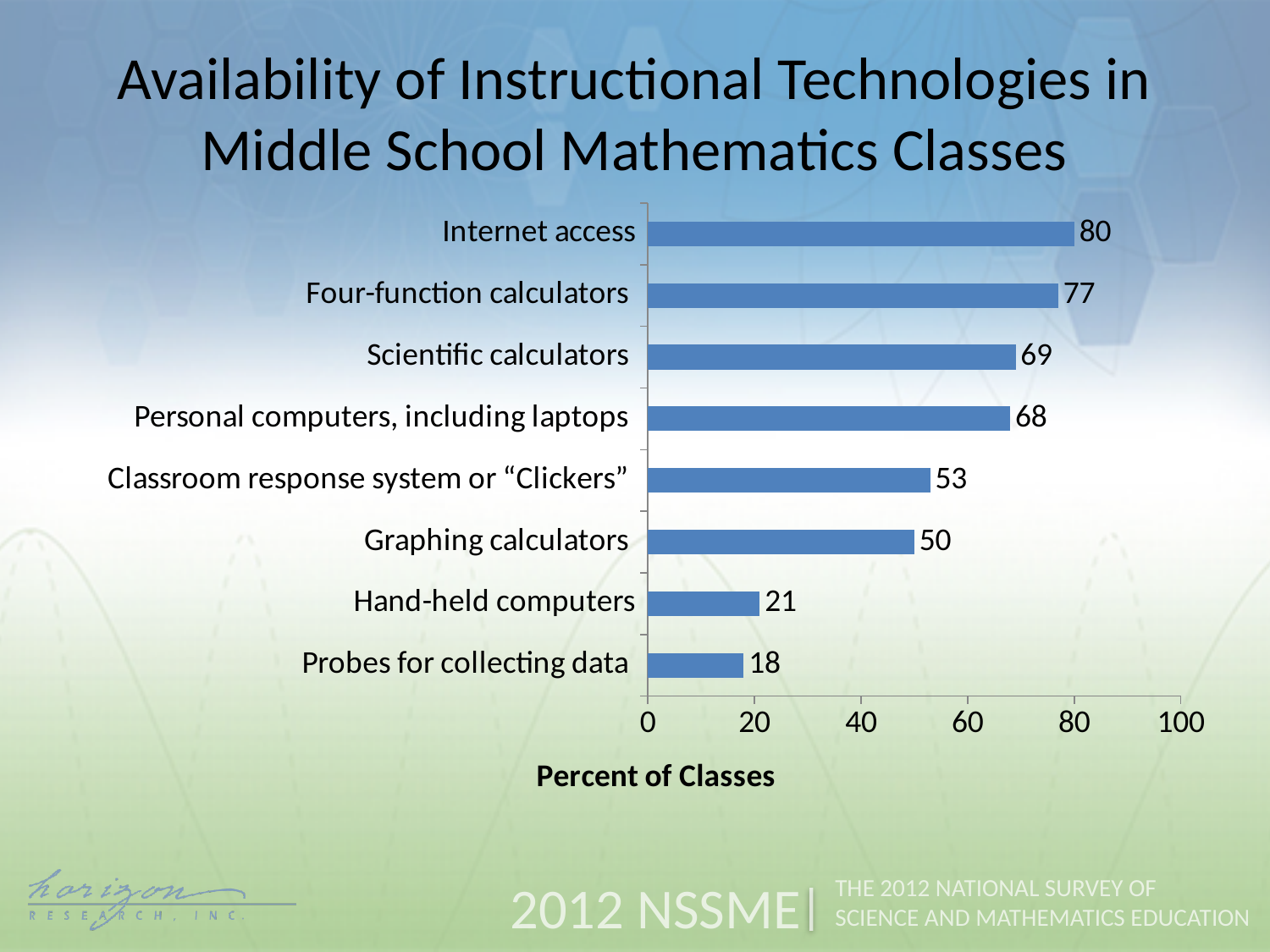
Which technology has the highest availability? Internet access What is the difference between the values for Four-function calculators and Graphing calculators? 27 What is the value for Graphing calculators? 50 What type of chart is shown on the slide? bar chart What is the label of the horizontal axis? Percent of Classes How many technologies are shown in the chart? 8 Which is larger: the value for Scientific calculators or Personal computers, including laptops? Scientific calculators What is the difference between the values for Hand-held computers and Probes for collecting data? 3 Which technology has the lowest availability? Probes for collecting data Is the value for Hand-held computers greater or less than 40? less What is the value for Classroom response system or "Clickers"? 53 What percent of classes have Internet access available? 80